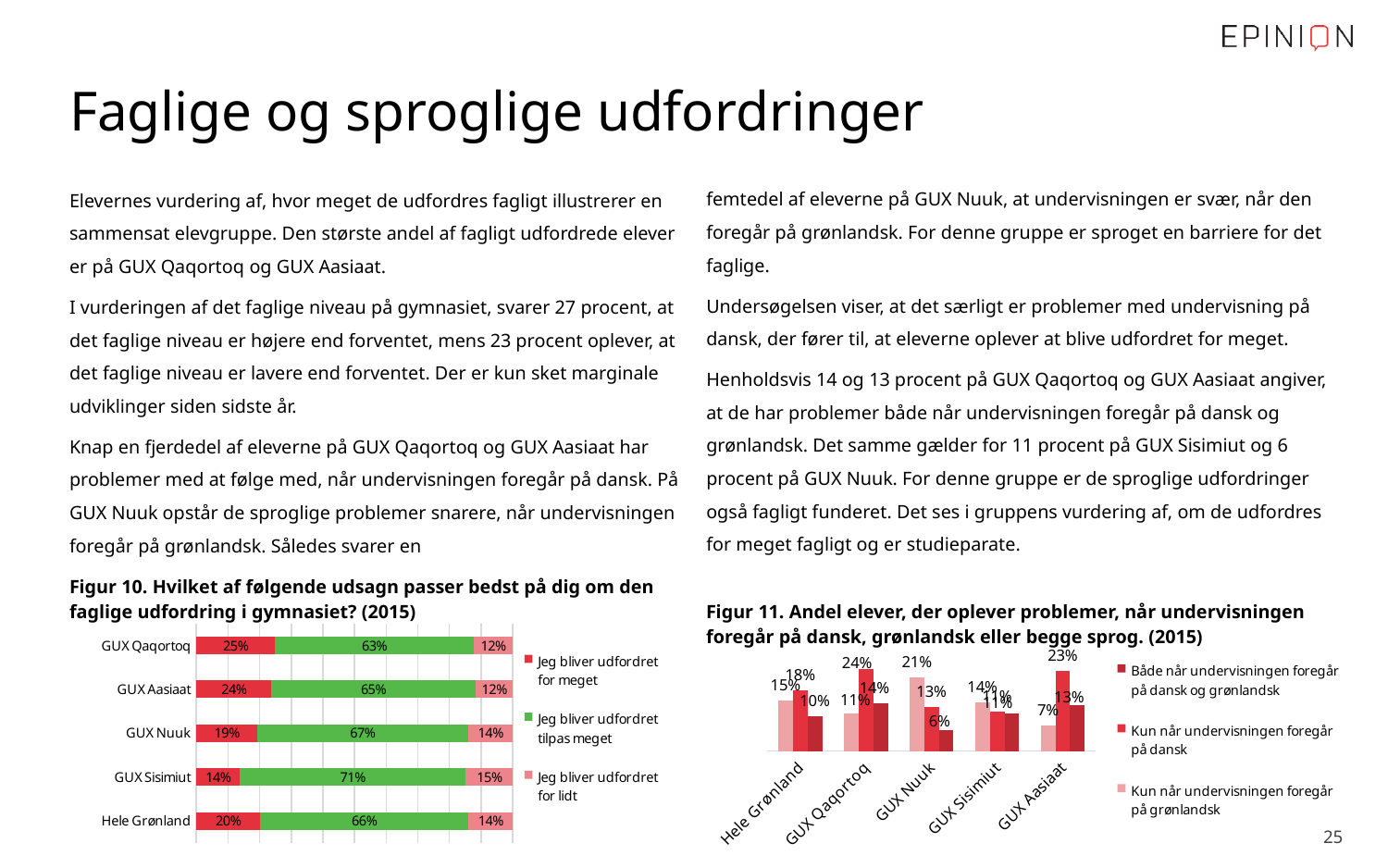
In Figur 11, what share of students at GUX Nuuk have problems both when teaching is in Danish and Greenlandic? 6% In Figur 10, what share of students at GUX Qaqortoq say 'Jeg bliver udfordret for meget'? 25% What type of chart is Figur 10? Stacked horizontal bar chart In Figur 10, which category has the lowest share for 'Jeg bliver udfordret for meget'? GUX Sisimiut In Figur 10, how many categories are shown on the vertical axis? 5 How many series does the legend of Figur 11 list? 3 In Figur 10, what share of students at GUX Sisimiut say 'Jeg bliver udfordret tilpas meget'? 71% In Figur 11, what share of students at GUX Qaqortoq have problems only when teaching is in Danish ('Kun når undervisningen foregår på dansk')? 24% In Figur 10, which category has the highest share for 'Jeg bliver udfordret tilpas meget'? GUX Sisimiut In Figur 10, what is the difference between the 'Jeg bliver udfordret for meget' shares for GUX Qaqortoq and GUX Nuuk? 6 percentage points In Figur 11, which category has the highest share for 'Kun når undervisningen foregår på dansk'? GUX Qaqortoq In Figur 11, what share of students at GUX Nuuk have problems only when teaching is in Greenlandic ('Kun når undervisningen foregår på grønlandsk')? 21%